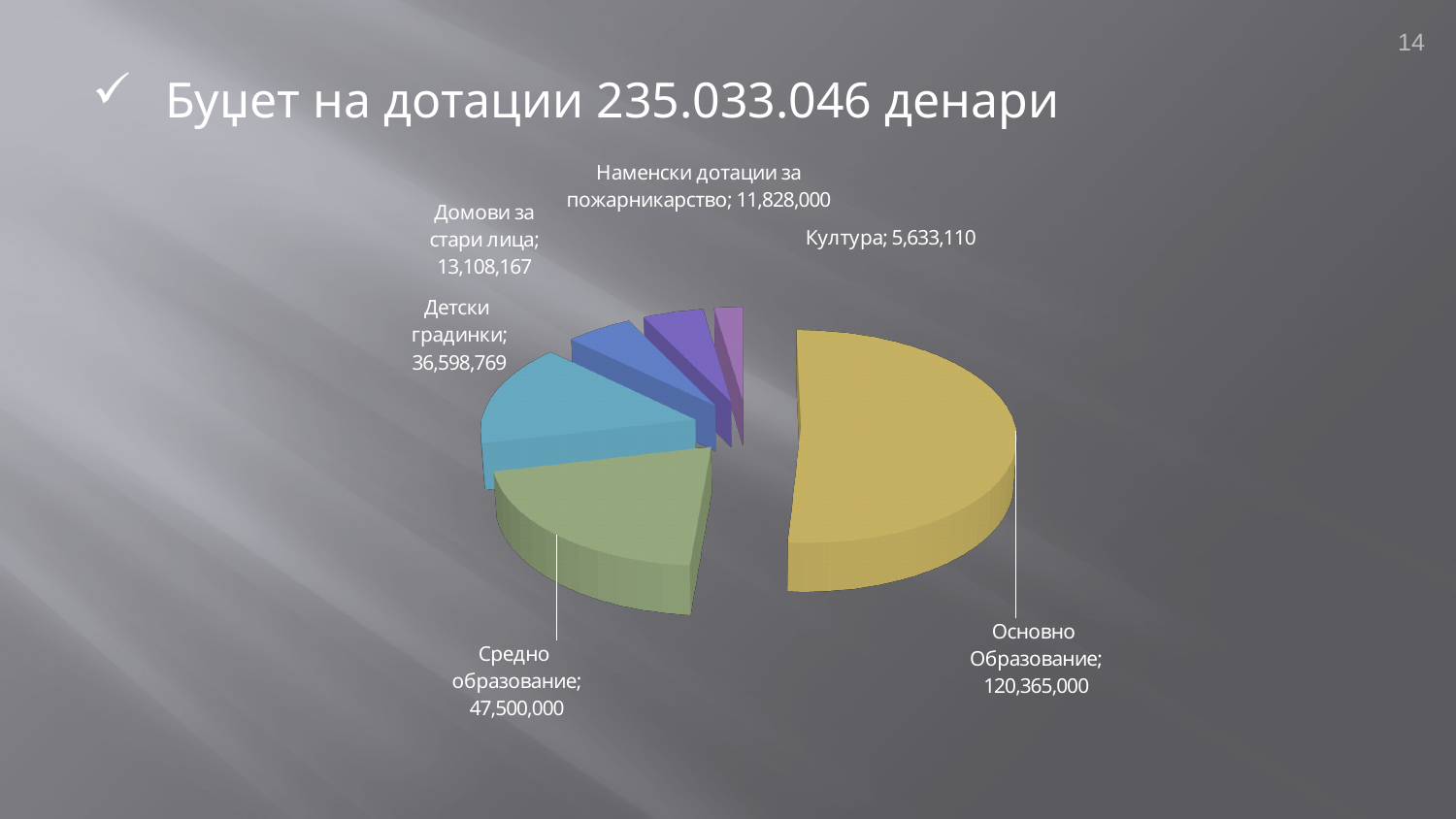
What is the value for Средно образование? 47,500,000 Which category has the smallest slice of the pie? Култура Which is larger, the value for Домови за стари лица or the value for Наменски дотации за пожарникарство? Домови за стари лица What is the value for Детски градинки? 36,598,769 What is the value for Основно Образование? 120,365,000 What kind of chart is shown on the slide? Pie chart What is the difference between the values for Основно Образование and Средно образование? 72,865,000 What total budget amount is stated in the slide title? 235.033.046 денари What share of the total budget does Основно Образование represent? 51.2% Which category has the largest slice of the pie? Основно Образование What is the value for Култура? 5,633,110 How many slices does the pie chart have? 6